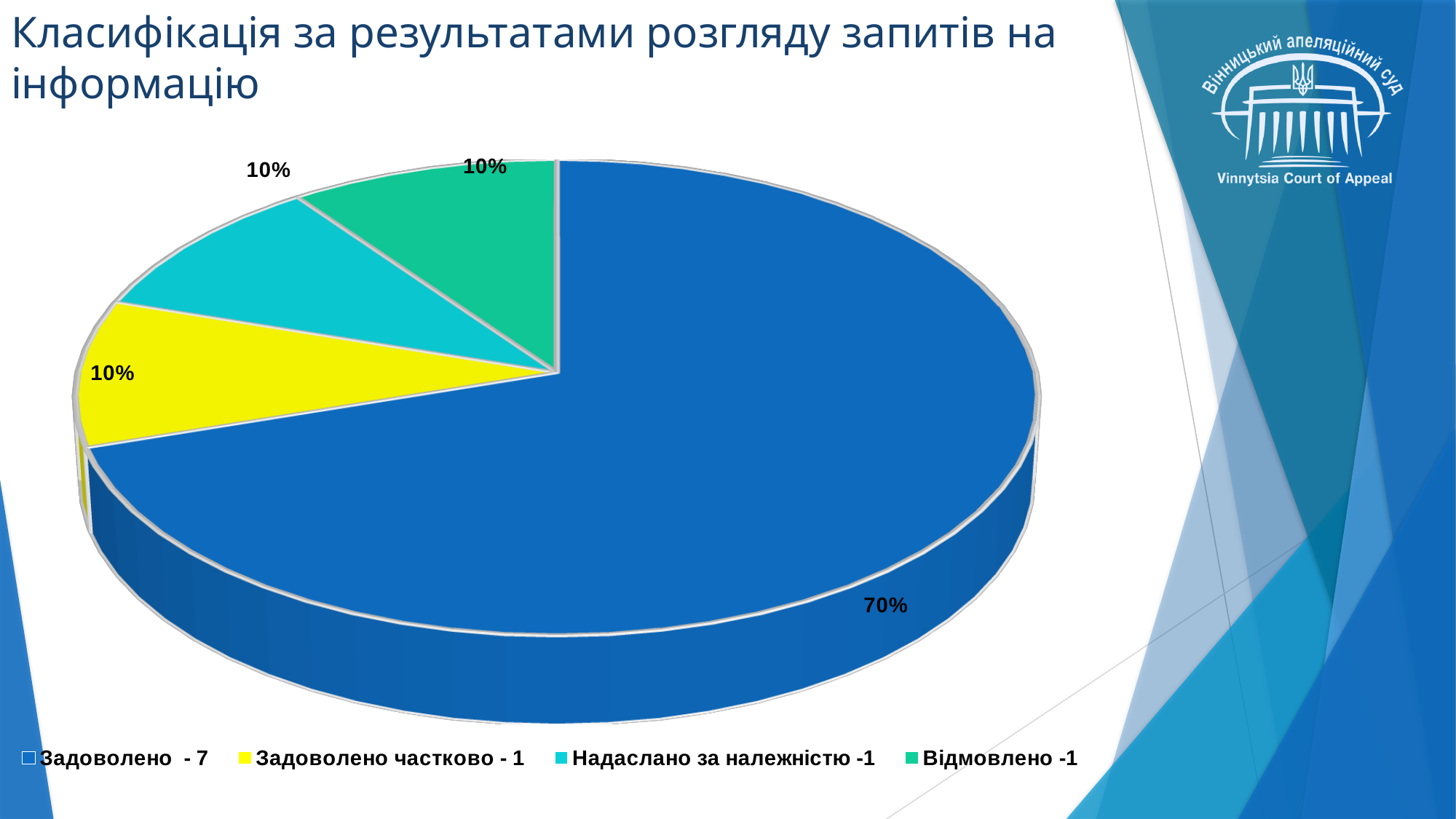
What kind of chart is shown on the slide? pie chart What share of the pie does the "Задоволено частково" slice represent? 10% What share of the pie does the "Задоволено" slice represent? 70% What share of the pie does the "Відмовлено" slice represent? 10% Which category has the largest slice of the pie? Задоволено What is the title of the chart slide? Класифікація за результатами розгляду запитів на інформацію Which is larger: the share for "Задоволено" or the share for "Відмовлено"? Задоволено What colour is the "Задоволено частково" slice? yellow What is the difference in percentage points between the "Задоволено" slice and the "Задоволено частково" slice? 60% How many slices does the pie chart have? 4 How many entries does the legend list? 4